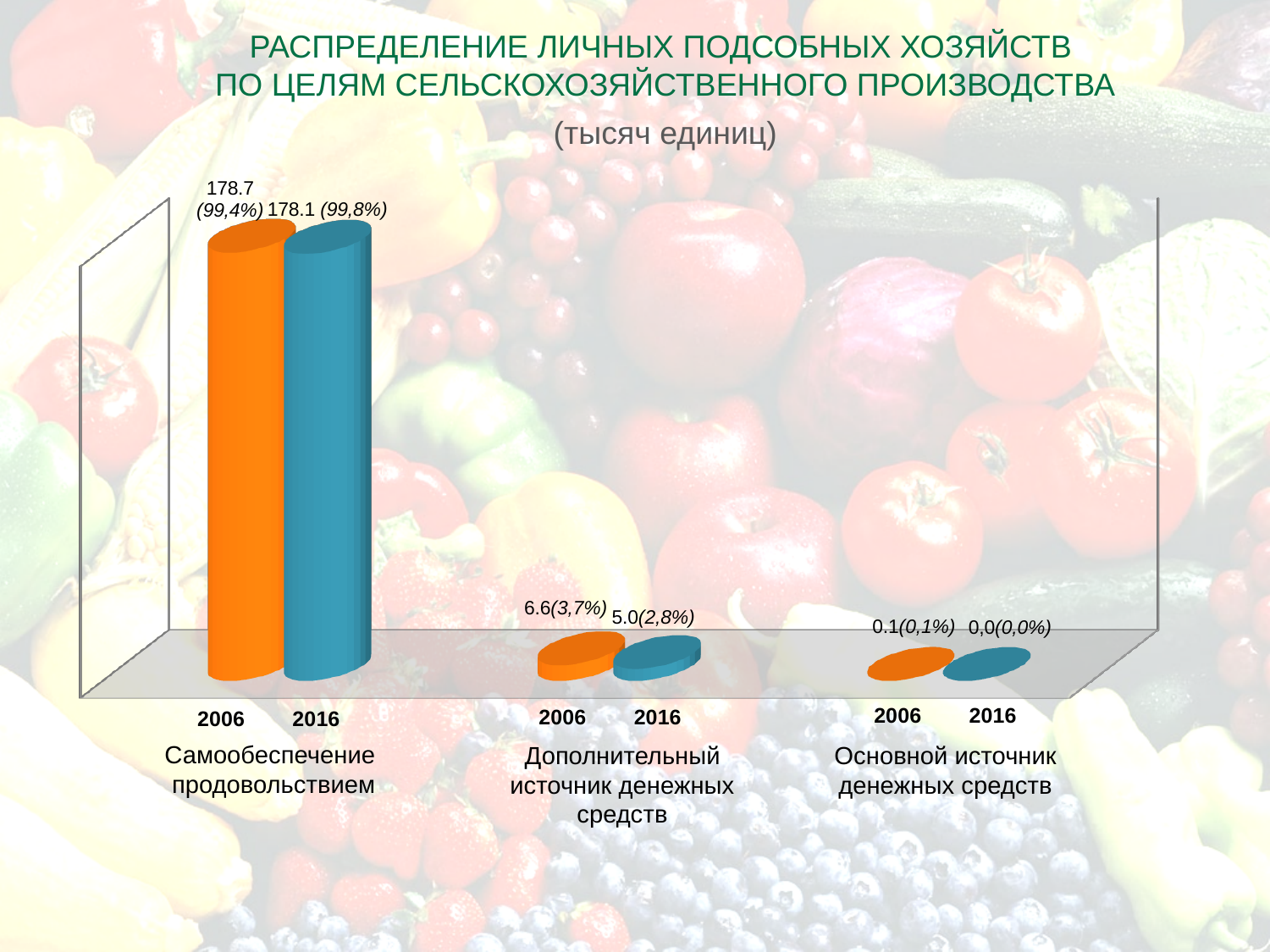
What unit is given in the chart's subtitle? тысяч единиц What kind of chart is shown on the slide? Bar chart What is the 2016 value for "Самообеспечение продовольствием"? 178.1 For "Самообеспечение продовольствием", which year has the larger value, 2006 or 2016? 2006 What is the 2006 value for "Самообеспечение продовольствием"? 178.7 Which category has the highest values in the chart? Самообеспечение продовольствием What is the difference between the 2006 and 2016 values for "Дополнительный источник денежных средств"? 1.6 Which category has the lowest values in the chart? Основной источник денежных средств What is the 2006 value for "Дополнительный источник денежных средств"? 6.6 What percentage is shown next to the 2016 value for "Основной источник денежных средств"? 0,0% How many categories are shown on the x axis of the chart? 3 What is the 2016 value for "Дополнительный источник денежных средств"? 5.0